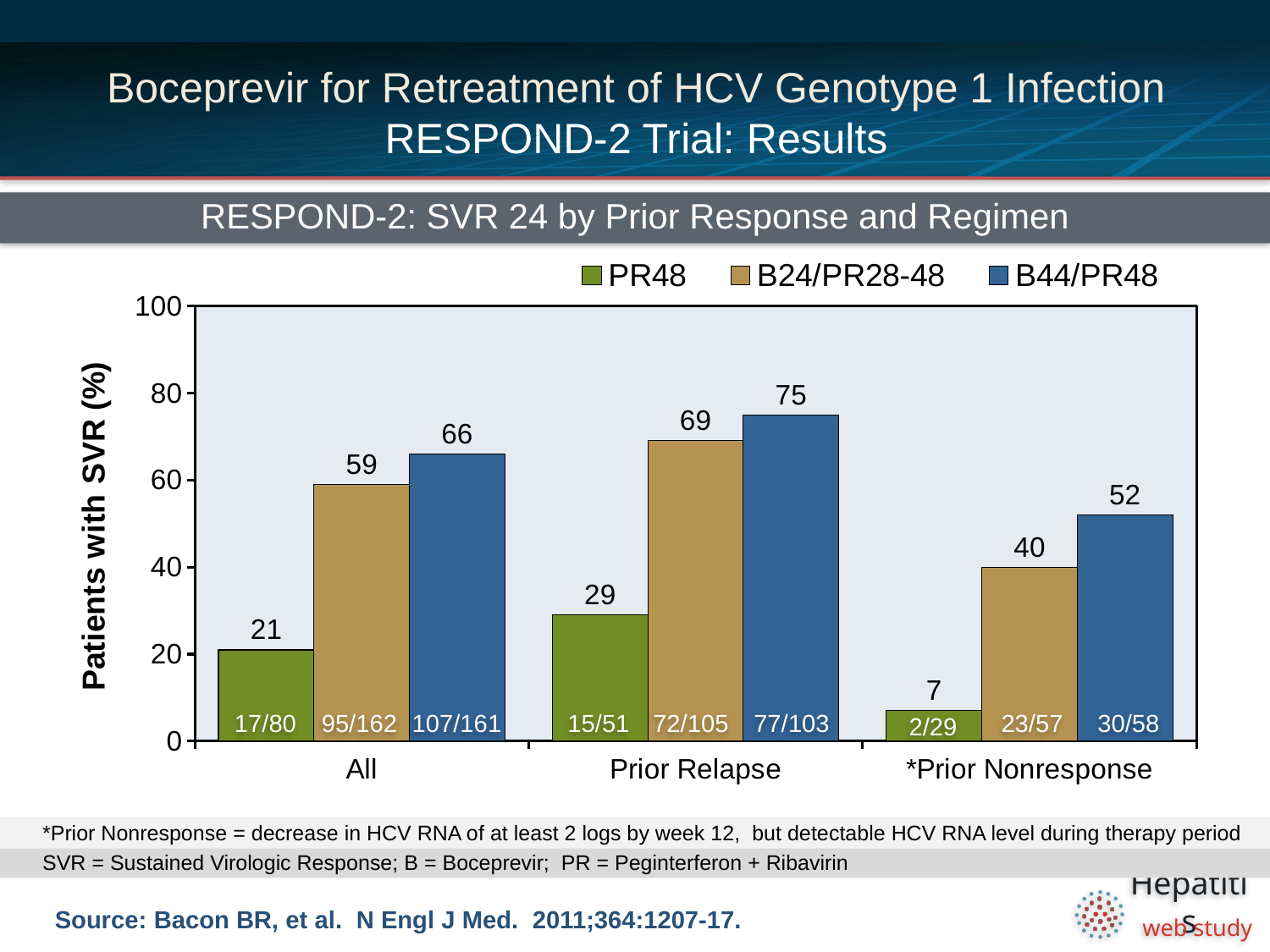
Which regimen has the lowest SVR rate in the *Prior Nonresponse group? PR48 What is the label of the y axis? Patients with SVR (%) Which is larger: the B24/PR28-48 SVR rate in the All group or the B44/PR48 SVR rate in the *Prior Nonresponse group? B24/PR28-48 in the All group What kind of chart is shown on the slide? Bar chart What is the SVR rate for B24/PR28-48 in the *Prior Nonresponse group? 40 What is the difference between the B44/PR48 SVR rates for Prior Relapse and *Prior Nonresponse? 23 What is the SVR rate for B44/PR48 in the All group? 66 How many series does the legend list? 3 What is the SVR rate for PR48 in the Prior Relapse group? 29 How many prior-response categories are shown on the x axis? 3 Which regimen has the highest SVR rate in the Prior Relapse group? B44/PR48 What is the difference between the B44/PR48 and PR48 SVR rates in the All group? 45